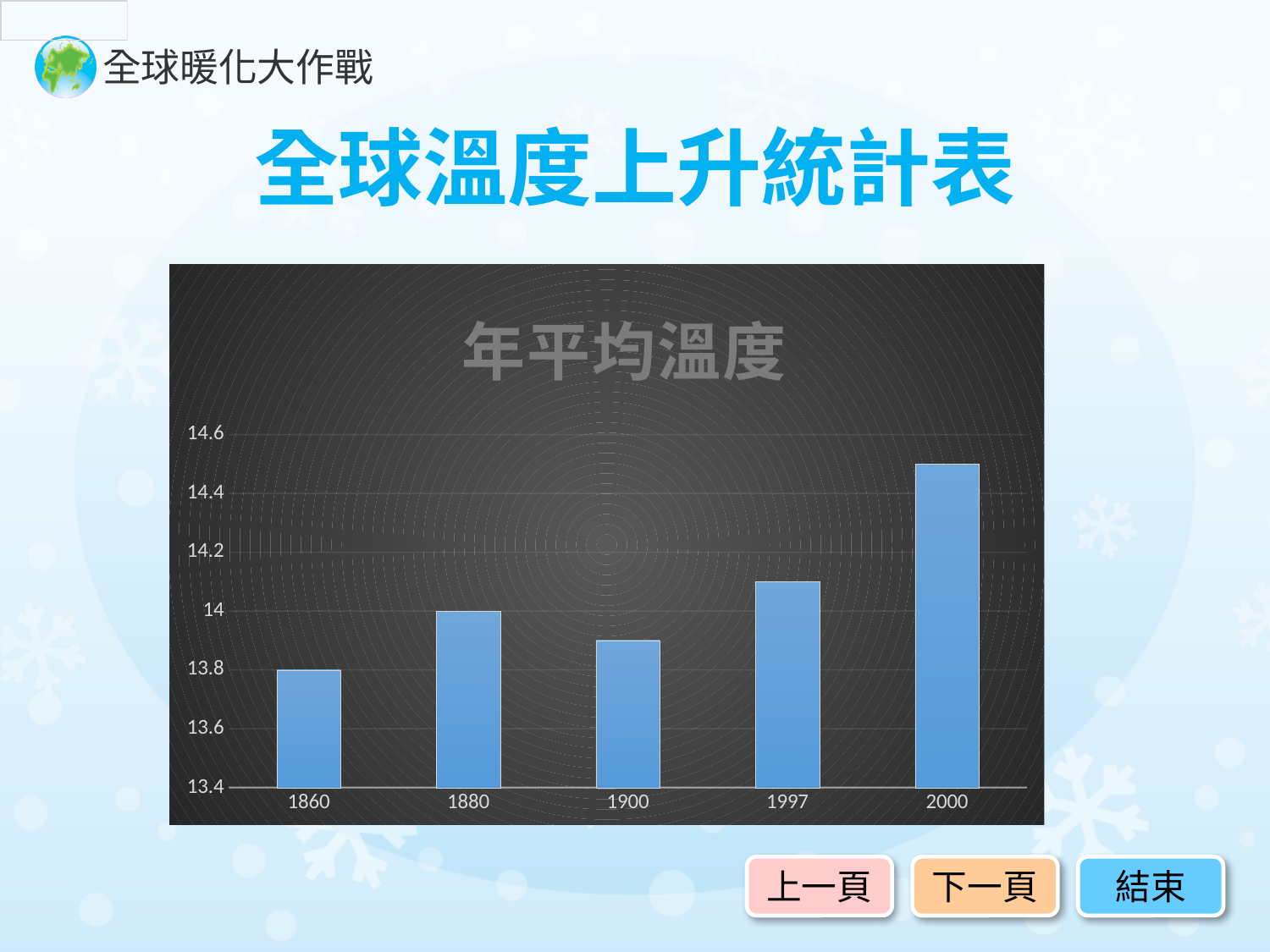
What is the difference between the values for 1880 and 1860? 0.2 Is the value for 1900 greater or less than 13.8? greater How many years (categories) are shown on the x axis of the chart? 5 Which year has the lowest average temperature in the chart? 1860 What is the average temperature value for 1880? 14 Which has the larger value, 1880 or 1900? 1880 What is the average temperature value for 1860? 13.8 Is the value for 1997 greater or less than 14? greater What is the title of the chart? 年平均溫度 What kind of chart is shown on the slide? bar chart Is the value for 2000 greater or less than 14.4? greater Which year has the highest average temperature in the chart? 2000